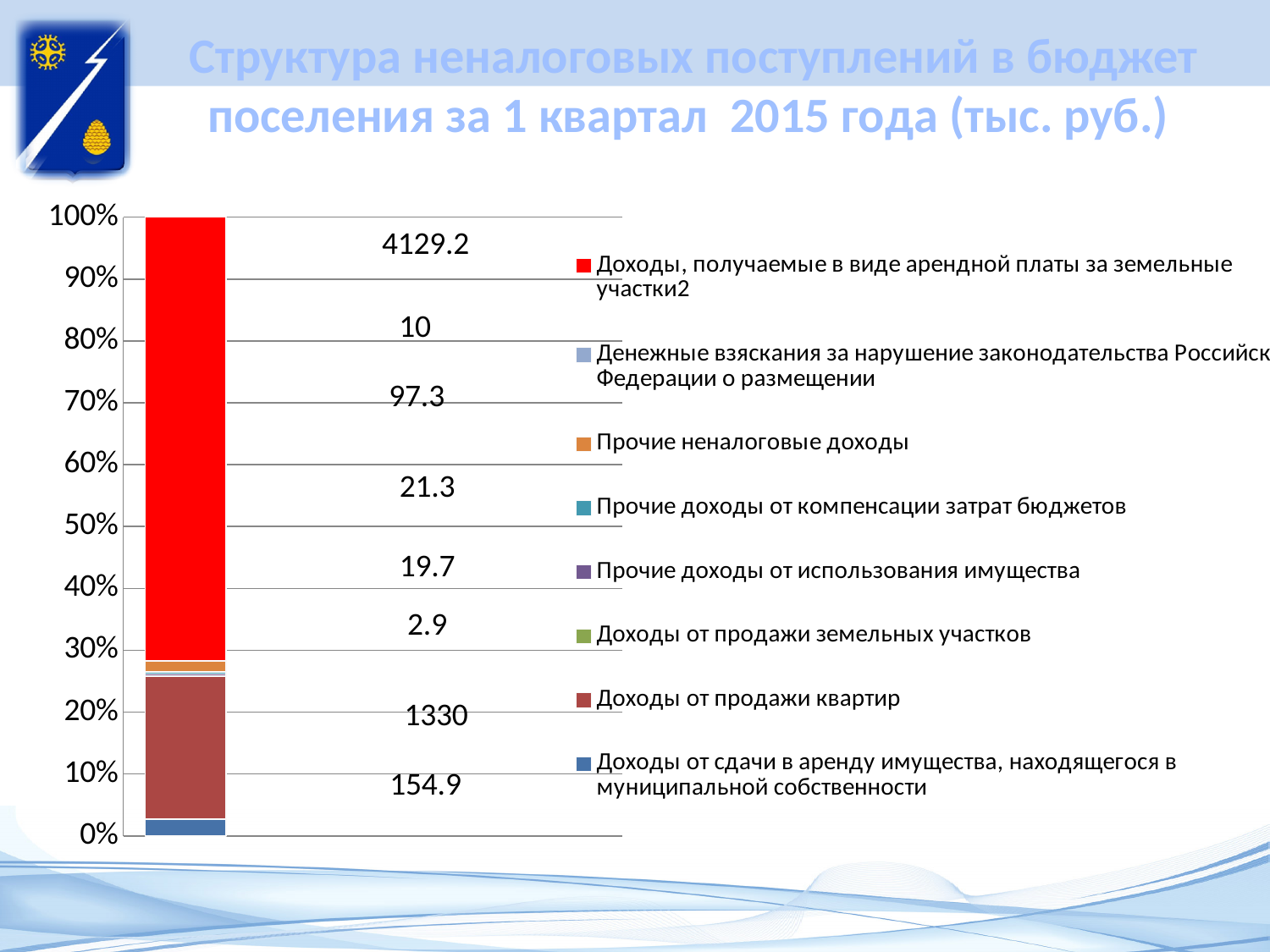
What is the value for "Доходы от сдачи в аренду имущества, находящегося в муниципальной собственности"? 154.9 What is the value for "Прочие неналоговые доходы"? 97.3 Which series has the highest value? Доходы, получаемые в виде арендной платы за земельные участки2 Which is larger: the value for "Прочие доходы от компенсации затрат бюджетов" or for "Прочие доходы от использования имущества"? Прочие доходы от компенсации затрат бюджетов What is the value for "Доходы от продажи земельных участков"? 2.9 Which series has the lowest value? Доходы от продажи земельных участков What is the difference between the values for "Доходы от продажи квартир" and "Доходы от сдачи в аренду имущества, находящегося в муниципальной собственности"? 1175.1 What is the value for "Доходы, получаемые в виде арендной платы за земельные участки2"? 4129.2 What kind of chart is shown on the slide? stacked bar chart What is the value for "Доходы от продажи квартир"? 1330 How many series does the legend list? 8 What is the total of all values in the stacked bar? 5765.3